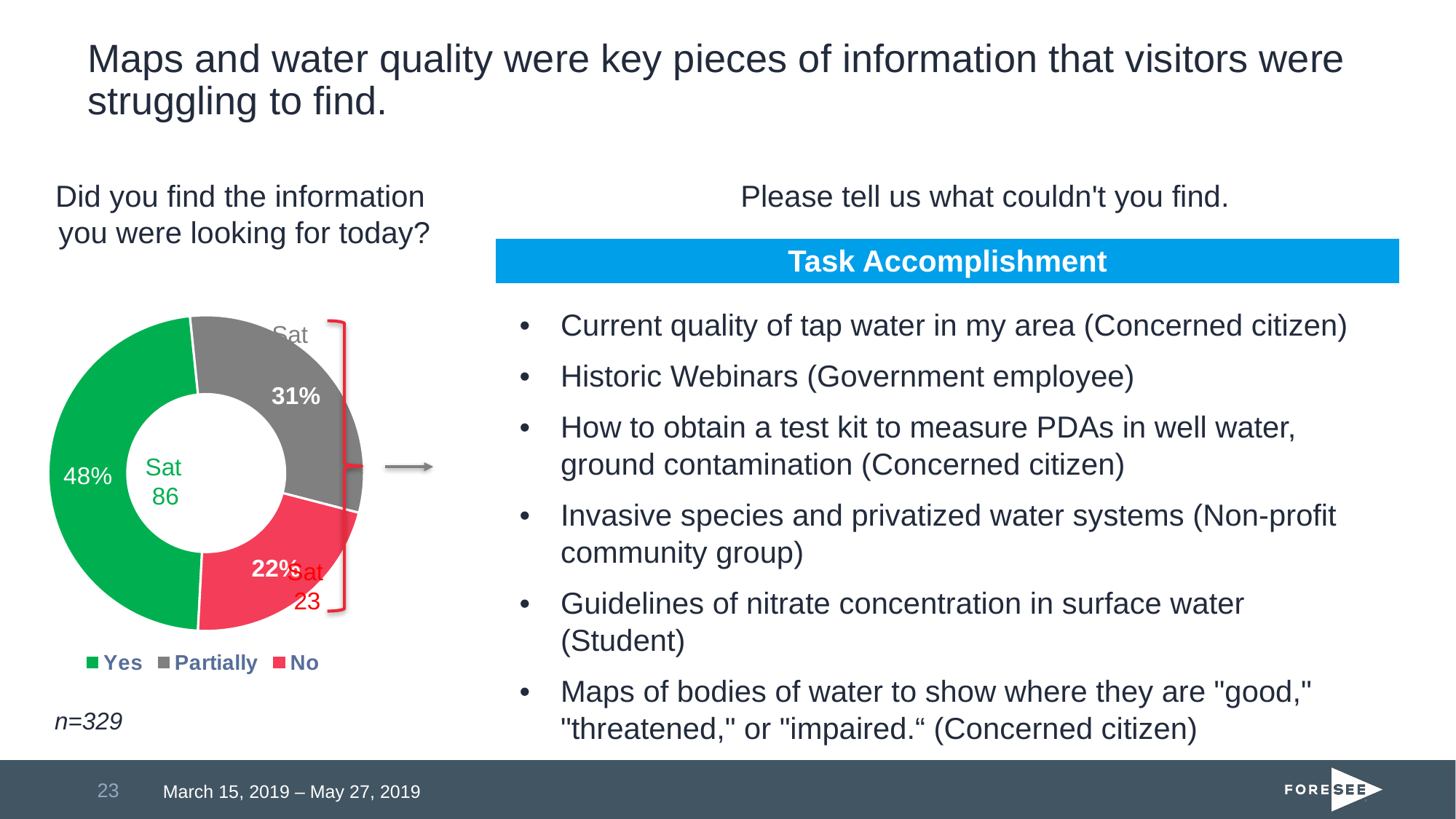
What type of chart is used to show whether visitors found the information they were looking for? Donut (pie) chart Which is larger, the share for "Partially" or the share for "No"? Partially What percentage of respondents answered "Partially"? 31% What is the difference in percentage points between the "Partially" and "No" shares? 9 How many response categories does the donut chart show? 3 Which response category has the largest share of the donut chart? Yes What is the sample size (n) shown for the donut chart? n=329 What is the difference in percentage points between the "Yes" and "No" shares? 26 What percentage of respondents answered "Yes" to finding the information they were looking for? 48% Which response category has the smallest share of the donut chart? No What colour represents the "No" category in the donut chart? Red What percentage of respondents answered "No"? 22%